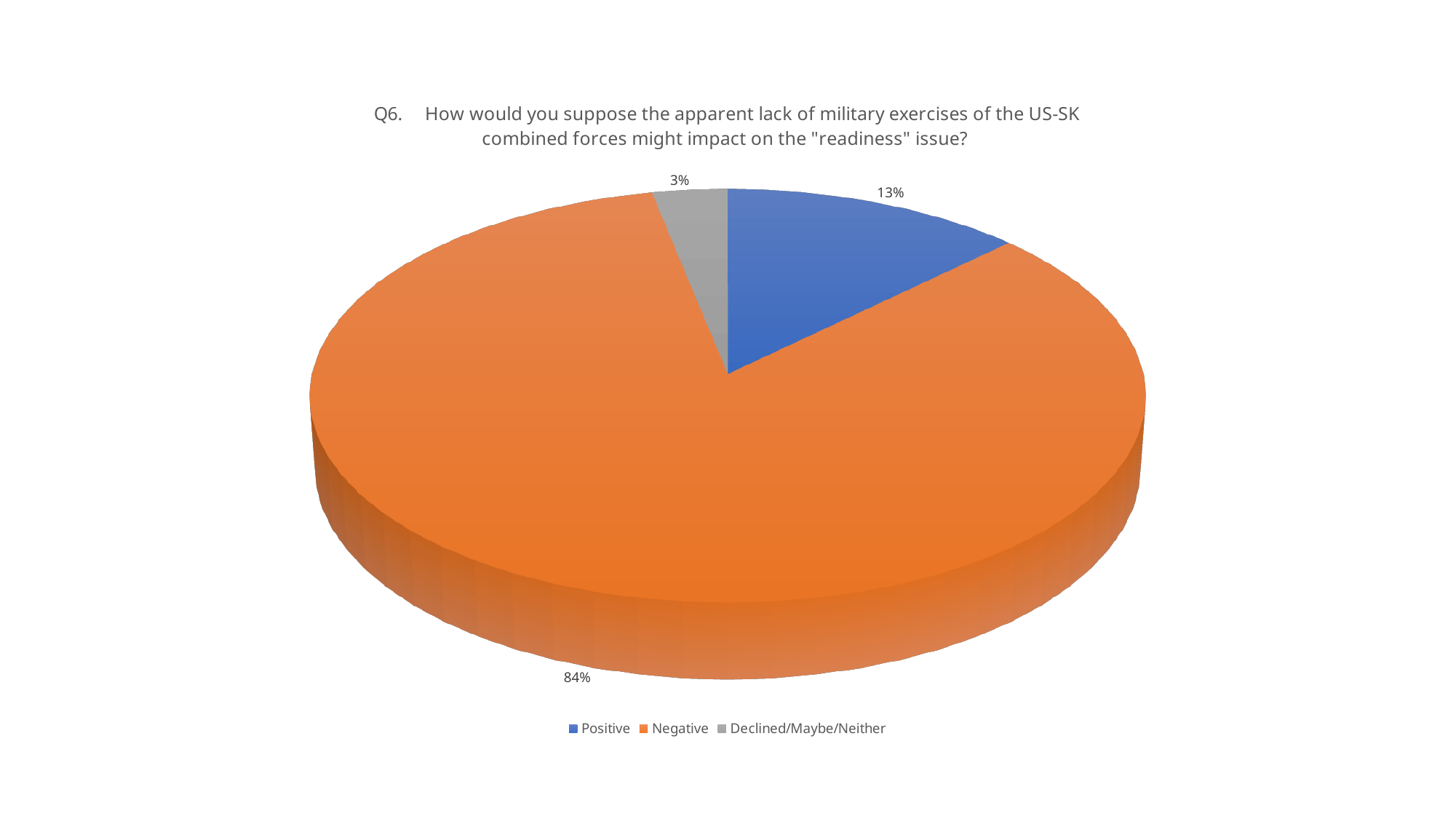
What question number is shown in the chart title? Q6 Which colour represents the Negative category? Orange Which response category has the smallest share? Declined/Maybe/Neither What share of responses is Positive? 13% What is the difference in percentage points between the Positive and Declined/Maybe/Neither shares? 10 Which is larger, the Positive share or the Declined/Maybe/Neither share? Positive How many categories does the pie chart have? 3 What share of responses is Declined/Maybe/Neither? 3% Which response category has the largest share? Negative What share of responses is Negative? 84% What is the difference in percentage points between the Negative and Positive shares? 71 What kind of chart is shown on the slide? Pie chart